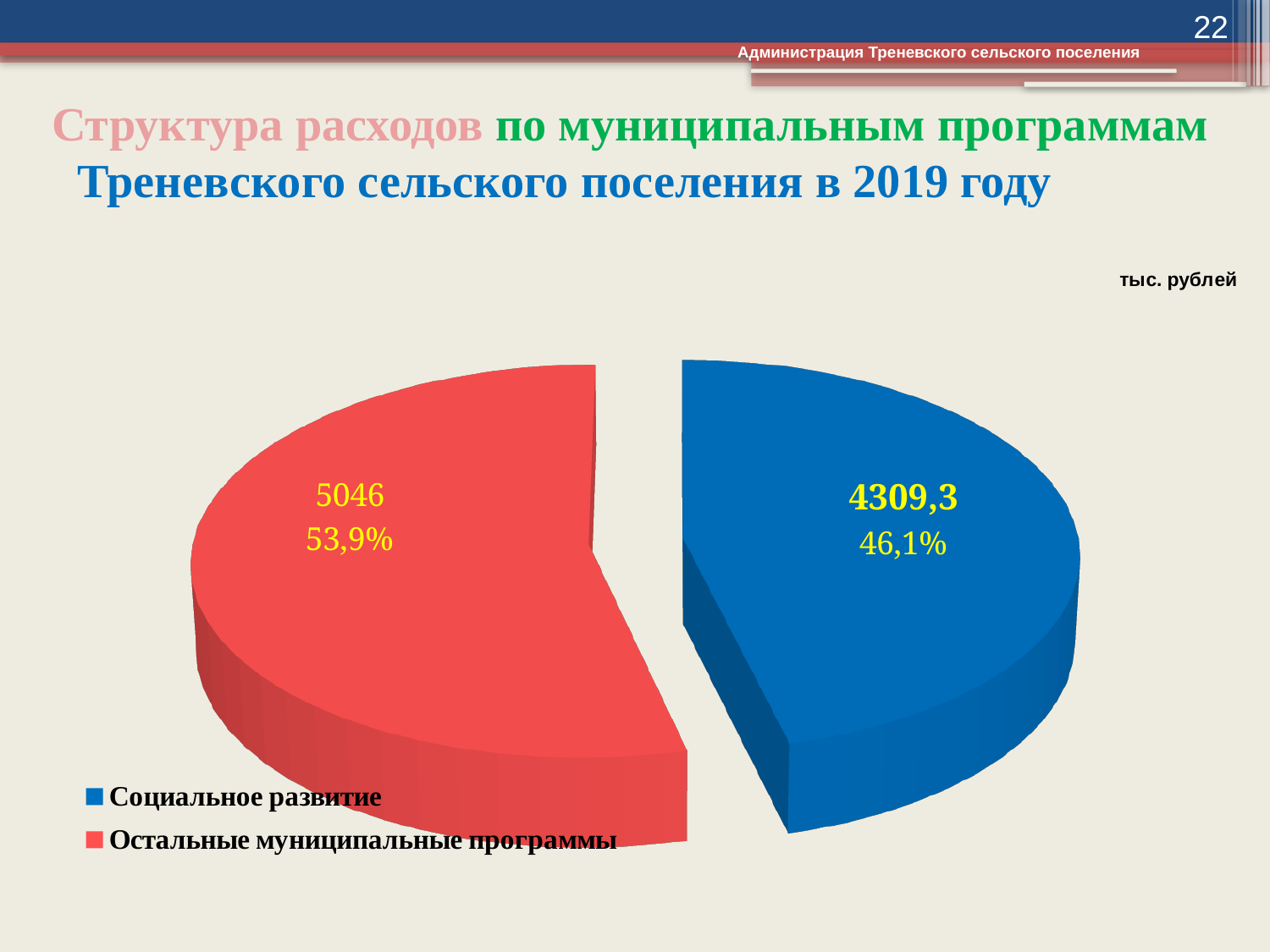
In what units are the chart values given? тыс. рублей How many slices does the pie chart have? 2 What colour is the slice for Социальное развитие? blue What is the difference between the values for Остальные муниципальные программы and Социальное развитие? 736,7 What is the value for Социальное развитие? 4309,3 What is the value for Остальные муниципальные программы? 5046 What kind of chart is shown on the slide? pie chart What share of the pie does Остальные муниципальные программы take? 53,9% Which category has the smallest slice? Социальное развитие Which is larger, Социальное развитие or Остальные муниципальные программы? Остальные муниципальные программы Which category has the largest slice? Остальные муниципальные программы What share of the pie does Социальное развитие take? 46,1%